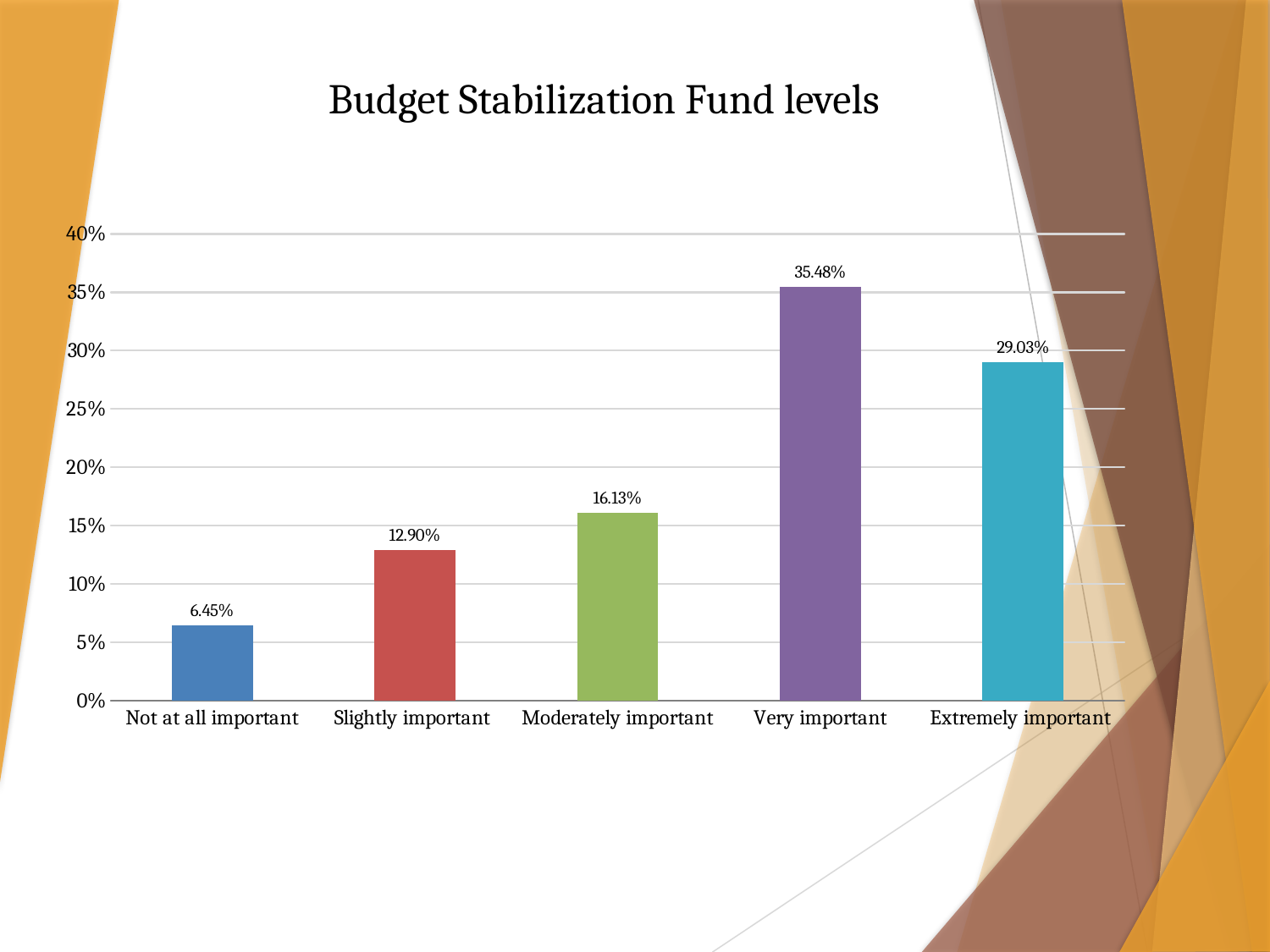
What is the value for Moderately important? 16.13% What is the value for Not at all important? 6.45% What is the difference between the values for Slightly important and Not at all important? 6.45% Which category has the lowest value? Not at all important Which category has the highest value? Very important What is the title of the chart? Budget Stabilization Fund levels Is the value for Slightly important greater or less than 15%? less What is the difference between the values for Very important and Extremely important? 6.45% How many categories are shown on the chart? 5 What kind of chart is shown on the slide? bar chart What is the value for Very important? 35.48% Which is larger, the value for Extremely important or the value for Moderately important? Extremely important